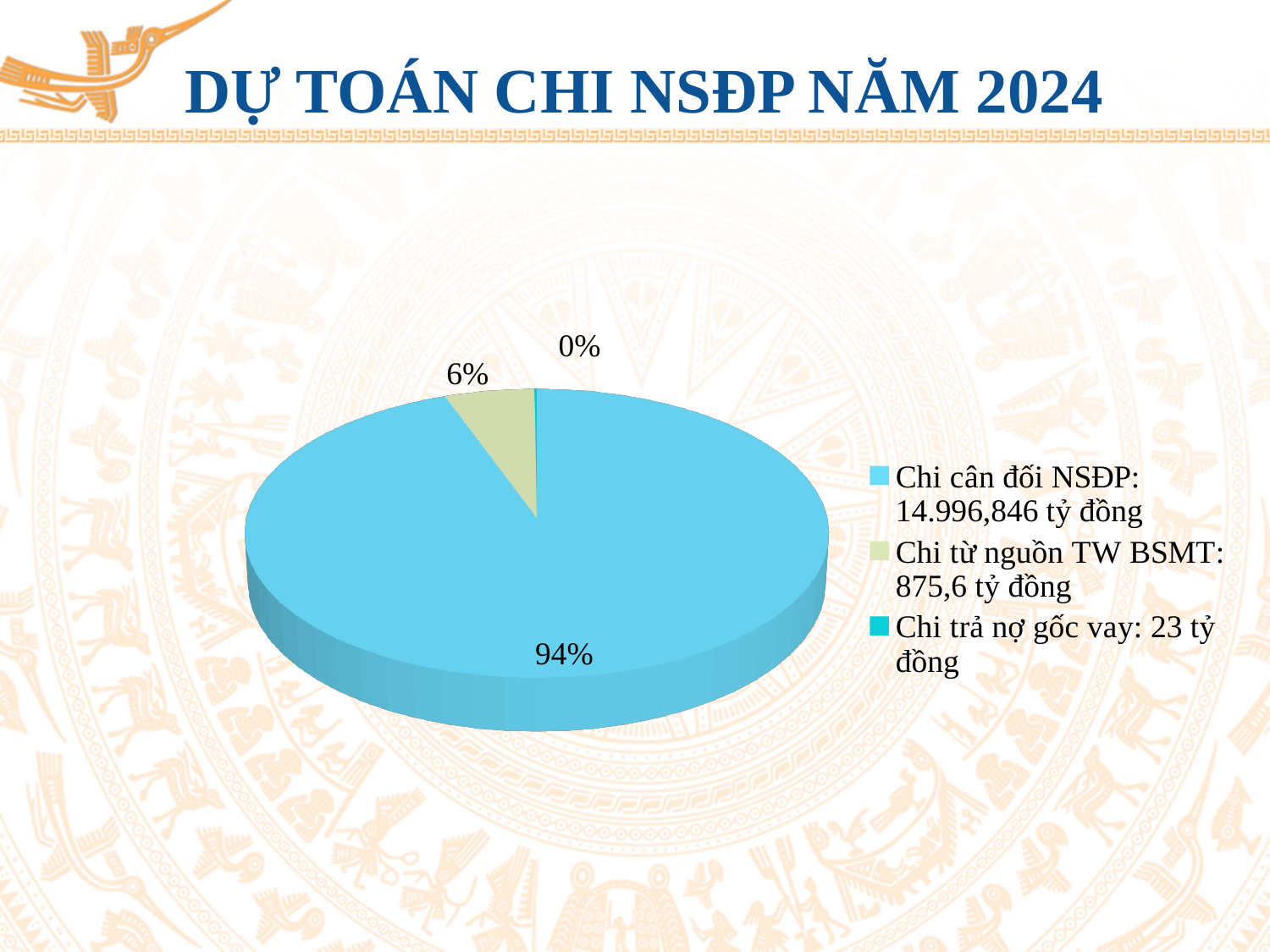
How many slices does the pie chart have? 3 Which is larger, the share for "Chi từ nguồn TW BSMT" or the share for "Chi trả nợ gốc vay"? Chi từ nguồn TW BSMT What kind of chart is shown on the slide? pie chart Which category has the largest slice of the pie? Chi cân đối NSĐP According to the legend, what amount is given for "Chi từ nguồn TW BSMT"? 875,6 tỷ đồng What share of the pie does "Chi trả nợ gốc vay" represent? 0% What share of the pie does "Chi từ nguồn TW BSMT" represent? 6% What is the difference in percentage points between the "Chi cân đối NSĐP" slice and the "Chi từ nguồn TW BSMT" slice? 88 percentage points How many entries does the legend list? 3 What share of the pie does "Chi cân đối NSĐP" represent? 94% What is the title of the slide containing the pie chart? DỰ TOÁN CHI NSĐP NĂM 2024 Which category has the smallest slice of the pie? Chi trả nợ gốc vay